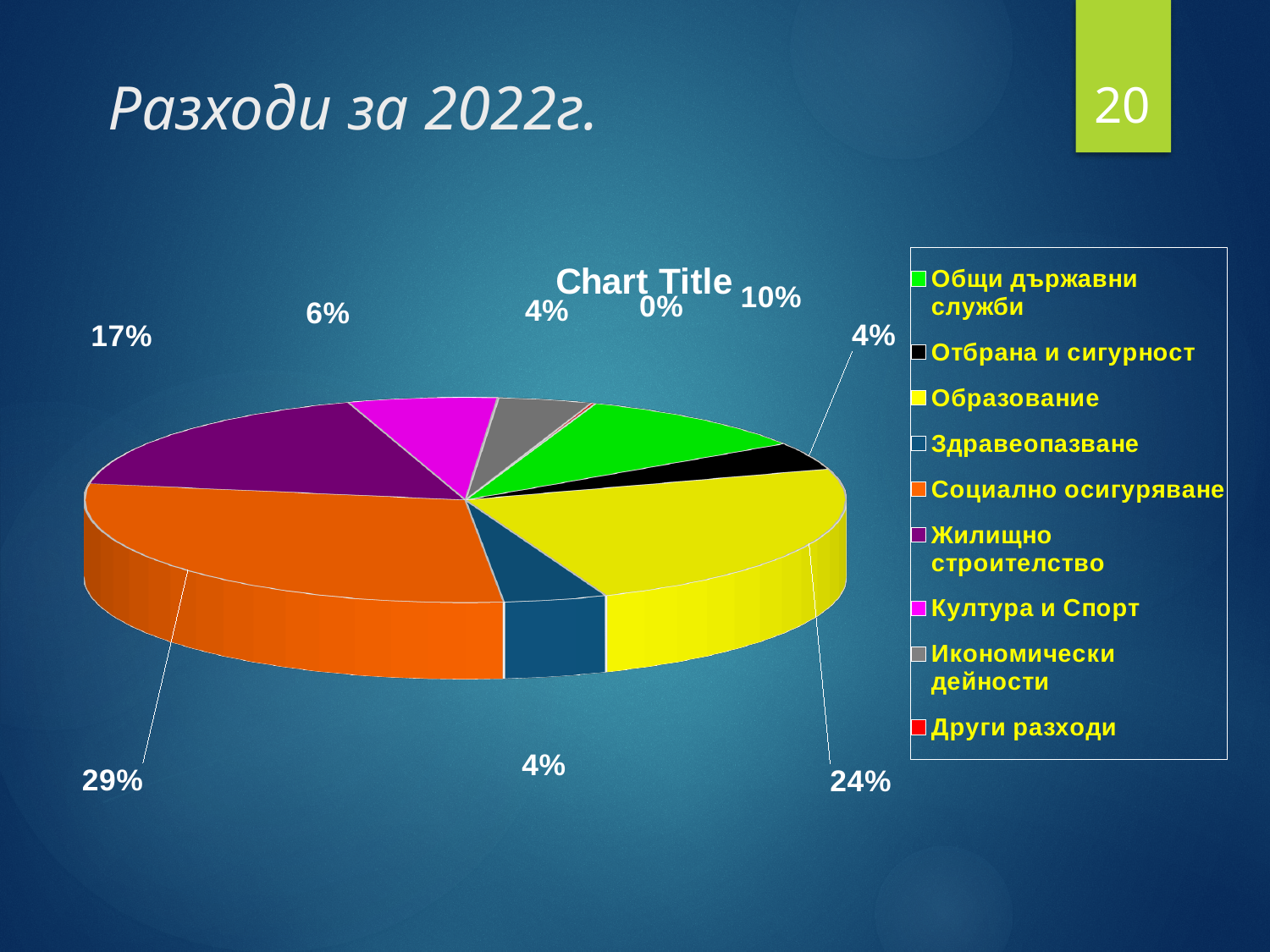
How many categories does the legend of the pie chart list? 9 What type of chart is shown on the slide? pie chart What share of the pie does Култура и Спорт have? 6% Which category has the largest share of the pie? Социално осигуряване What share of the pie does Други разходи have? 0% Which is larger, the share for Жилищно строителство or the share for Общи държавни служби? Жилищно строителство What share of the pie does Образование have? 24% What share of the pie does Общи държавни служби have? 10% What is the difference in percentage points between Социално осигуряване and Образование? 5 What share of the pie does Жилищно строителство have? 17% What share of the pie does Социално осигуряване have? 29% Which category has the smallest share of the pie? Други разходи